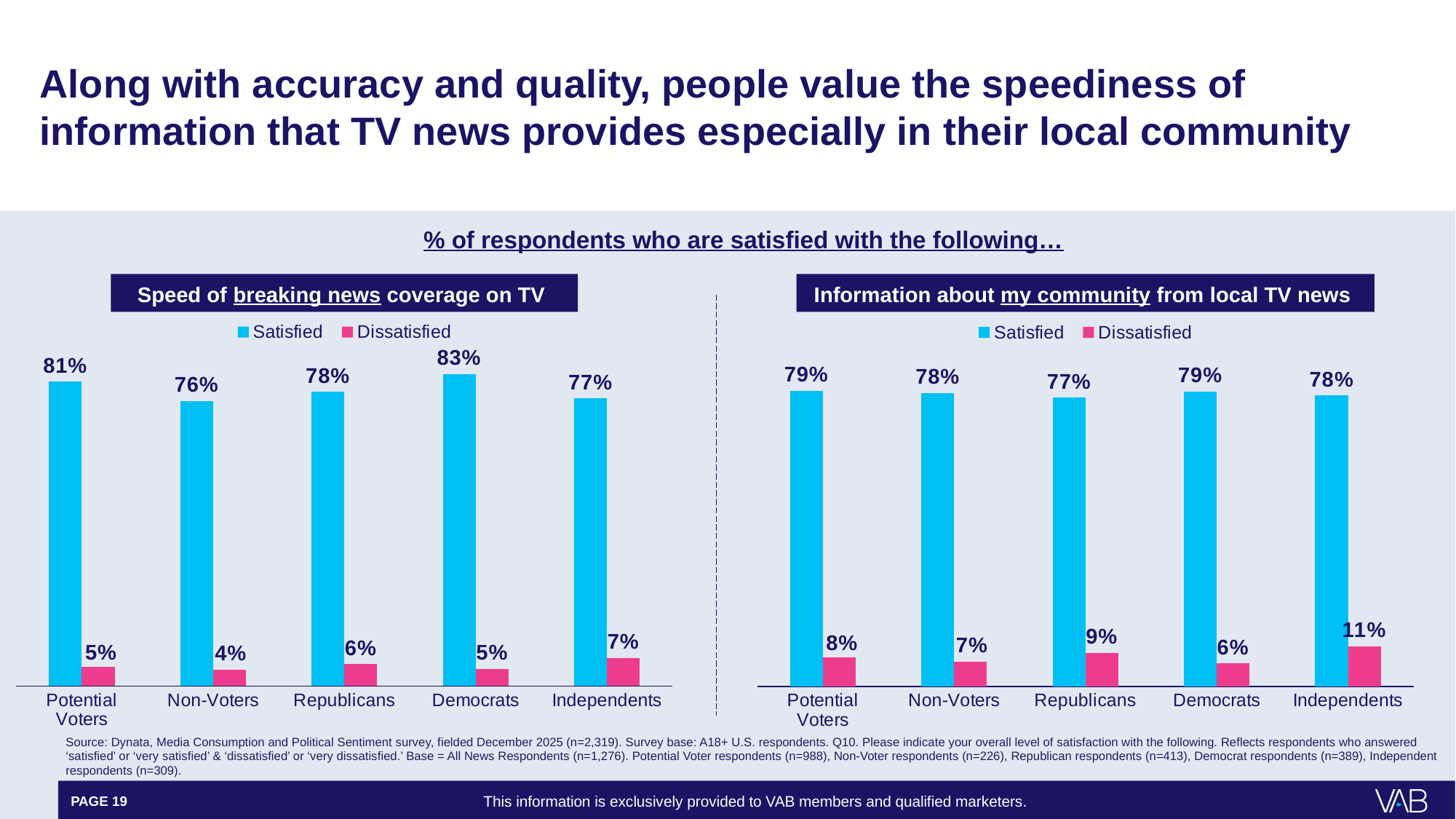
In the 'Speed of breaking news coverage on TV' chart, which category has the lowest Dissatisfied value? Non-Voters In the 'Information about my community from local TV news' chart, what is the difference between the Dissatisfied values for Independents and Democrats? 5% How many categories are shown on the x axis of the 'Information about my community from local TV news' chart? 5 In the 'Speed of breaking news coverage on TV' chart, which category has the highest Satisfied value? Democrats In the 'Speed of breaking news coverage on TV' chart, is the Satisfied value higher for Potential Voters or for Republicans? Potential Voters What kind of chart is the 'Information about my community from local TV news' chart? Bar chart In the 'Information about my community from local TV news' chart, what percentage of Independents are dissatisfied? 11% In the 'Information about my community from local TV news' chart, which category has the highest Dissatisfied value? Independents In the 'Speed of breaking news coverage on TV' chart, what percentage of Democrats are satisfied? 83% In the 'Speed of breaking news coverage on TV' chart, what colour represents the Dissatisfied series? Pink In the 'Speed of breaking news coverage on TV' chart, what is the difference between the Satisfied values for Democrats and Non-Voters? 7% How many series does the legend of the 'Speed of breaking news coverage on TV' chart list? 2